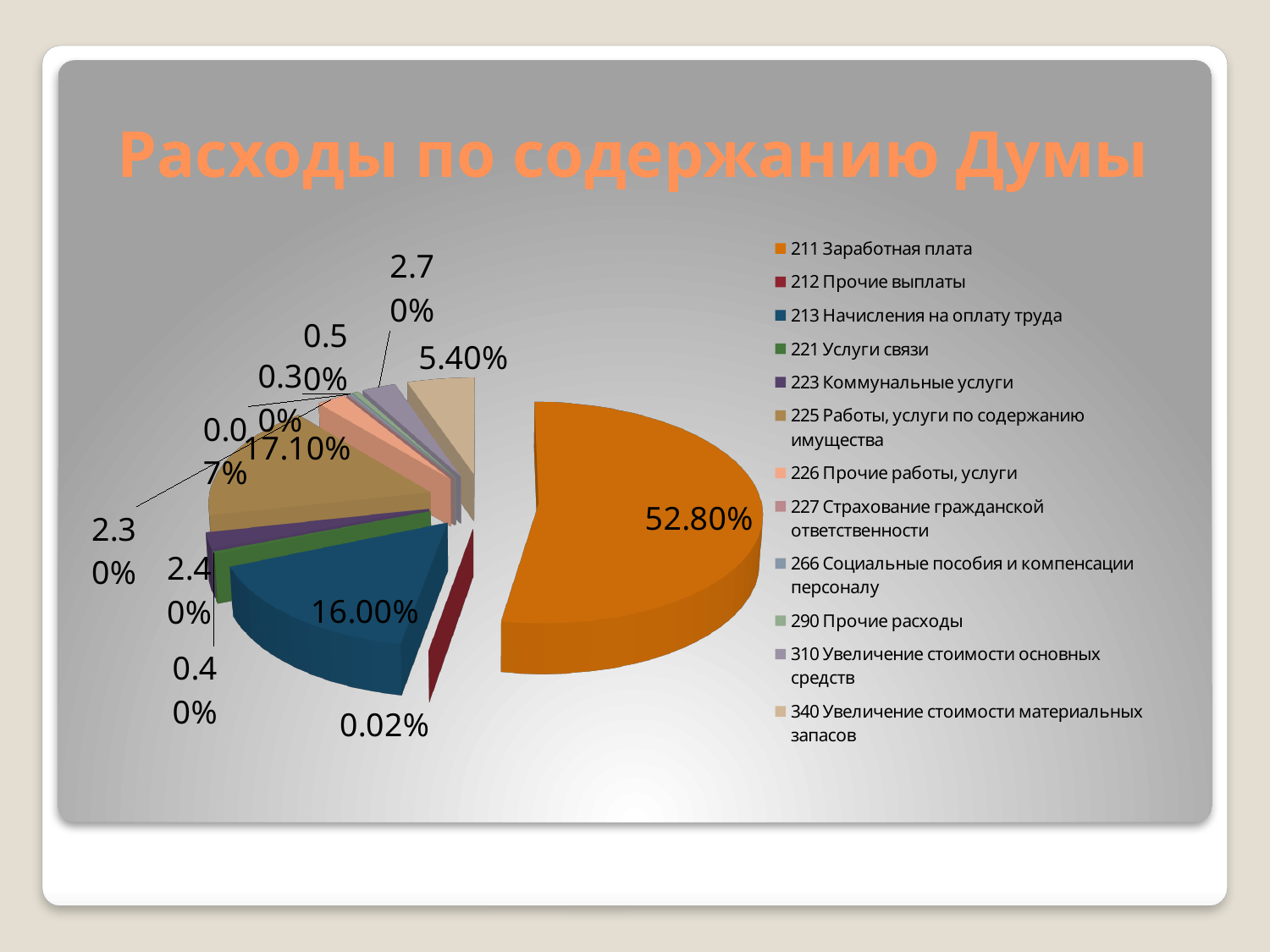
What kind of chart is shown on the slide? pie chart Which is larger: the share for "225 Работы, услуги по содержанию имущества" or for "213 Начисления на оплату труда"? 225 Работы, услуги по содержанию имущества What share of the pie does "213 Начисления на оплату труда" take? 16.00% What colour is the slice for "211 Заработная плата"? orange What share of the pie does "211 Заработная плата" take? 52.80% What is the difference between the shares of "211 Заработная плата" and "213 Начисления на оплату труда"? 36.80% What share of the pie does "340 Увеличение стоимости материальных запасов" take? 5.40% What share of the pie does "225 Работы, услуги по содержанию имущества" take? 17.10% Which category has the largest slice of the pie? 211 Заработная плата What is the title of the chart? Расходы по содержанию Думы Which category has the smallest slice of the pie? 212 Прочие выплаты How many entries does the chart legend list? 12